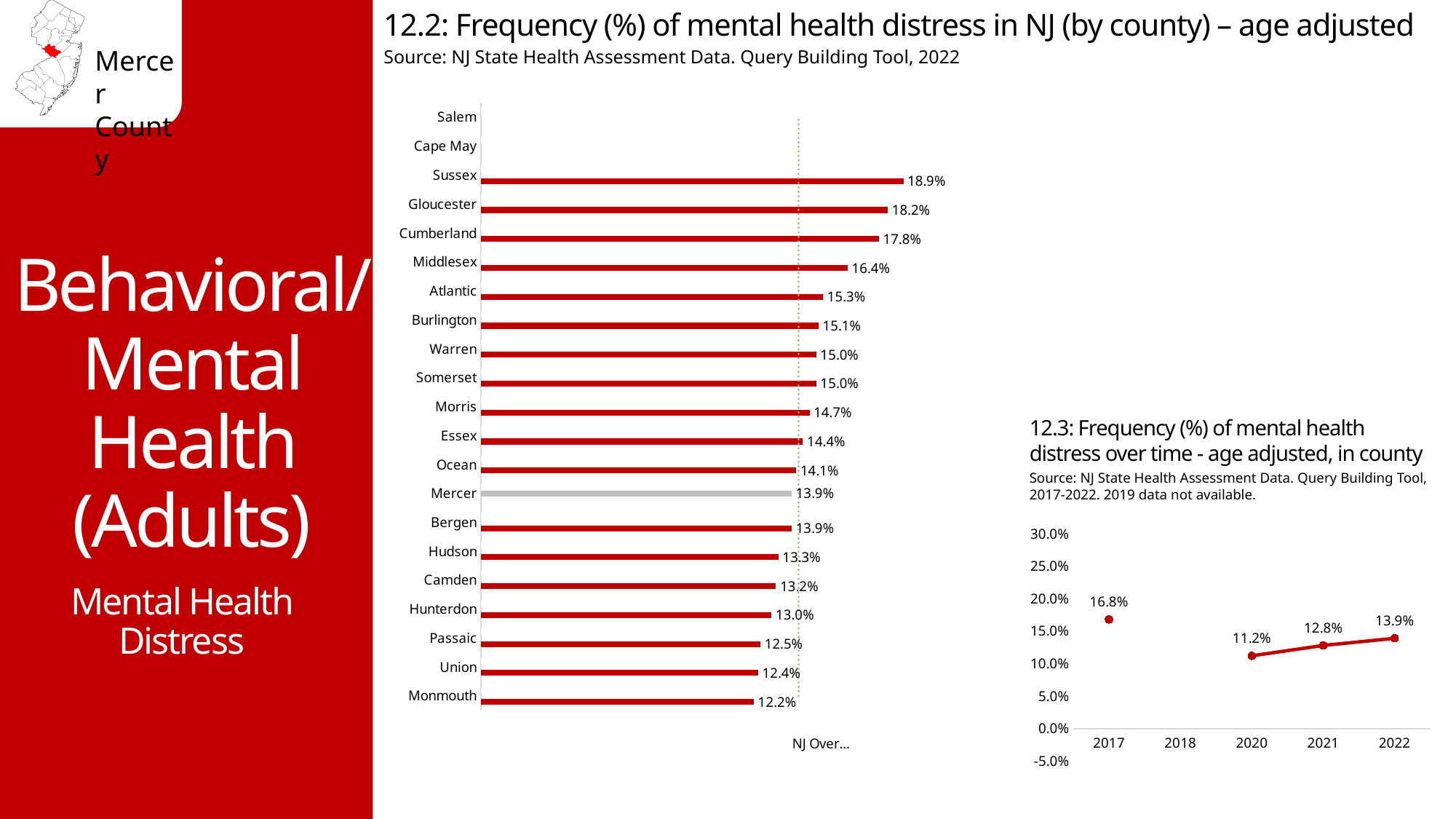
In chart 12.2, which is larger, the value for Atlantic or the value for Essex? Atlantic In chart 12.2, what is the value for Mercer? 13.9% In chart 12.2, which county with a plotted bar has the lowest value? Monmouth In chart 12.3, do the values rise or fall from 2020 to 2022? Rise In chart 12.2, which county's bar is shown in grey instead of red? Mercer In chart 12.2, what kind of chart is shown? Bar chart In chart 12.3, what is the value for 2020? 11.2% In chart 12.2, what is the value for Cumberland? 17.8% In chart 12.3, what is the difference between the values for 2022 and 2020? 2.7% In chart 12.2, what is the difference between the values for Sussex and Monmouth? 6.7% In chart 12.2, which county has the highest value? Sussex In chart 12.3, which year has the highest value? 2017